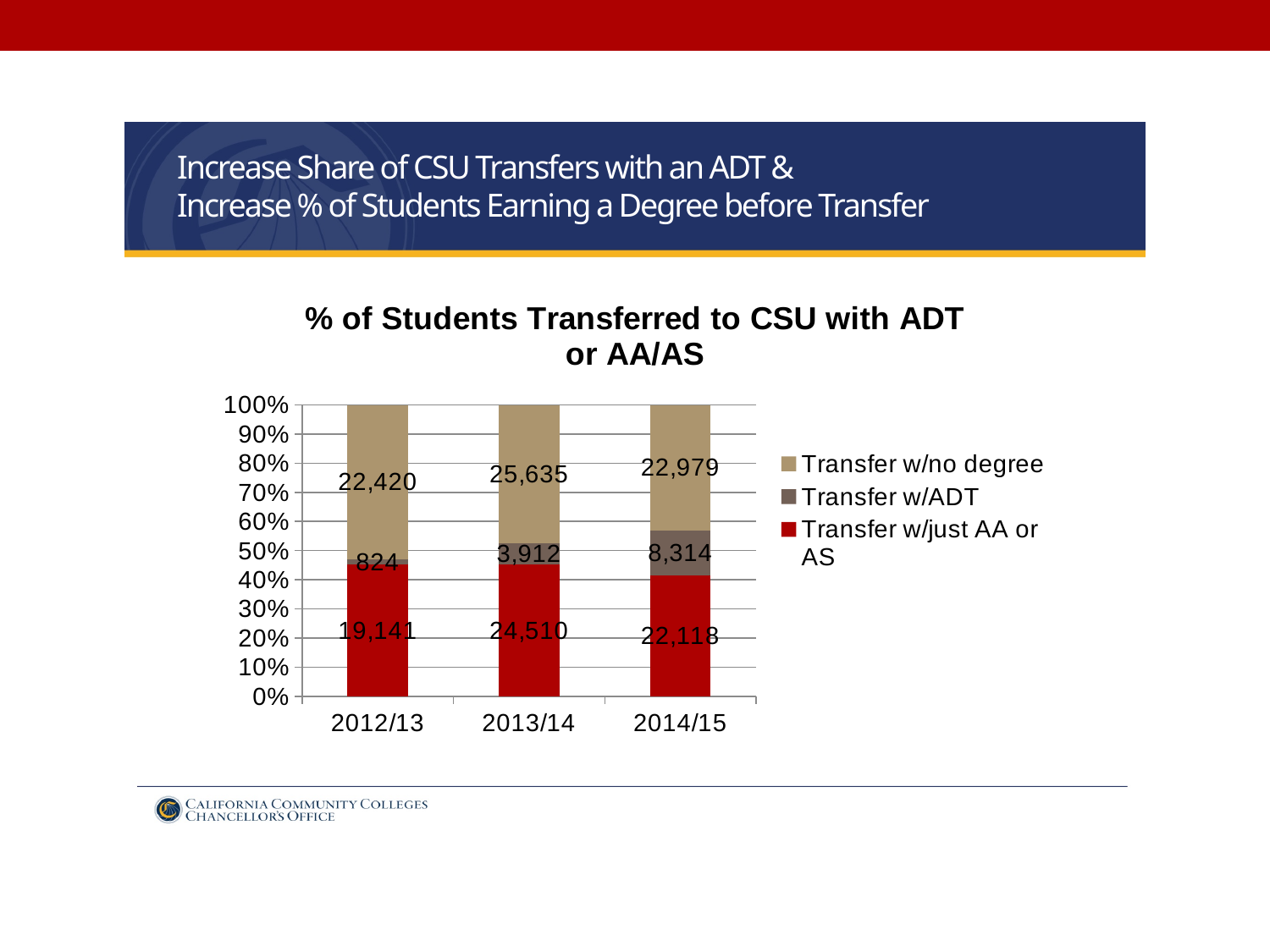
What is the difference between the Transfer w/ADT values in 2014/15 and 2012/13? 7,490 Does the Transfer w/ADT value rise or fall from 2012/13 to 2014/15? Rise What is the title of the chart? % of Students Transferred to CSU with ADT or AA/AS Which is larger: Transfer w/no degree in 2013/14 or Transfer w/no degree in 2014/15? Transfer w/no degree in 2013/14 What is the value for Transfer w/no degree in 2013/14? 25,635 In which year is the Transfer w/just AA or AS value lowest? 2012/13 How many series does the legend list? 3 What type of chart is shown on the slide? Stacked bar chart In which year is the Transfer w/ADT value highest? 2014/15 What is the value for Transfer w/just AA or AS in 2014/15? 22,118 How many academic years are shown on the x axis? 3 What is the value for Transfer w/ADT in 2012/13? 824